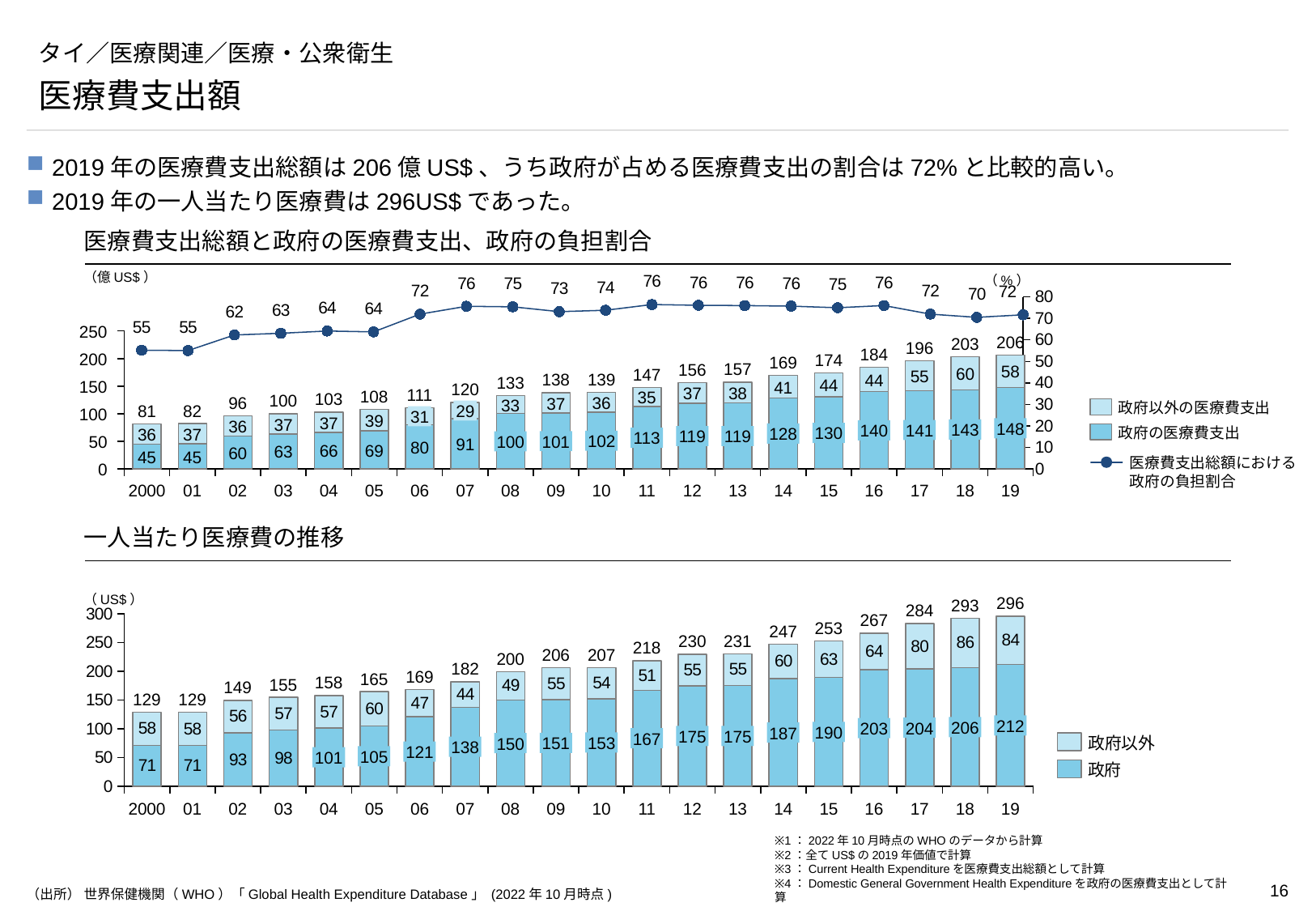
In the top chart (医療費支出総額と政府の医療費支出、政府の負担割合), what is the total medical expenditure for 2010? 139 In the bottom chart (一人当たり医療費の推移), what is the value of 政府 for 2016? 203 In the top chart (医療費支出総額と政府の医療費支出、政府の負担割合), what is the value of 政府の医療費支出 for 2019? 148 In the bottom chart (一人当たり医療費の推移), which year has the highest total per-capita medical expenditure? 19 (296) In the top chart (医療費支出総額と政府の医療費支出、政府の負担割合), what is the 政府の負担割合 (%) for 2007? 76 In the bottom chart (一人当たり医療費の推移), what kind of chart is it? Stacked bar chart In the bottom chart (一人当たり医療費の推移), what is the value of 政府以外 for 2018? 86 In the top chart (医療費支出総額と政府の医療費支出、政府の負担割合), which year has the lowest 政府の負担割合 on the line? 2000 and 01 (55) In the top chart (医療費支出総額と政府の医療費支出、政府の負担割合), how many series does the legend list? 3 In the bottom chart (一人当たり医療費の推移), how many years are plotted on the x axis? 20 In the top chart (医療費支出総額と政府の医療費支出、政府の負担割合), what is the difference between the total for 2019 and the total for 2000? 125 In the bottom chart (一人当たり医療費の推移), is the 政府以外 value larger in 2017 or in 2019? 2019